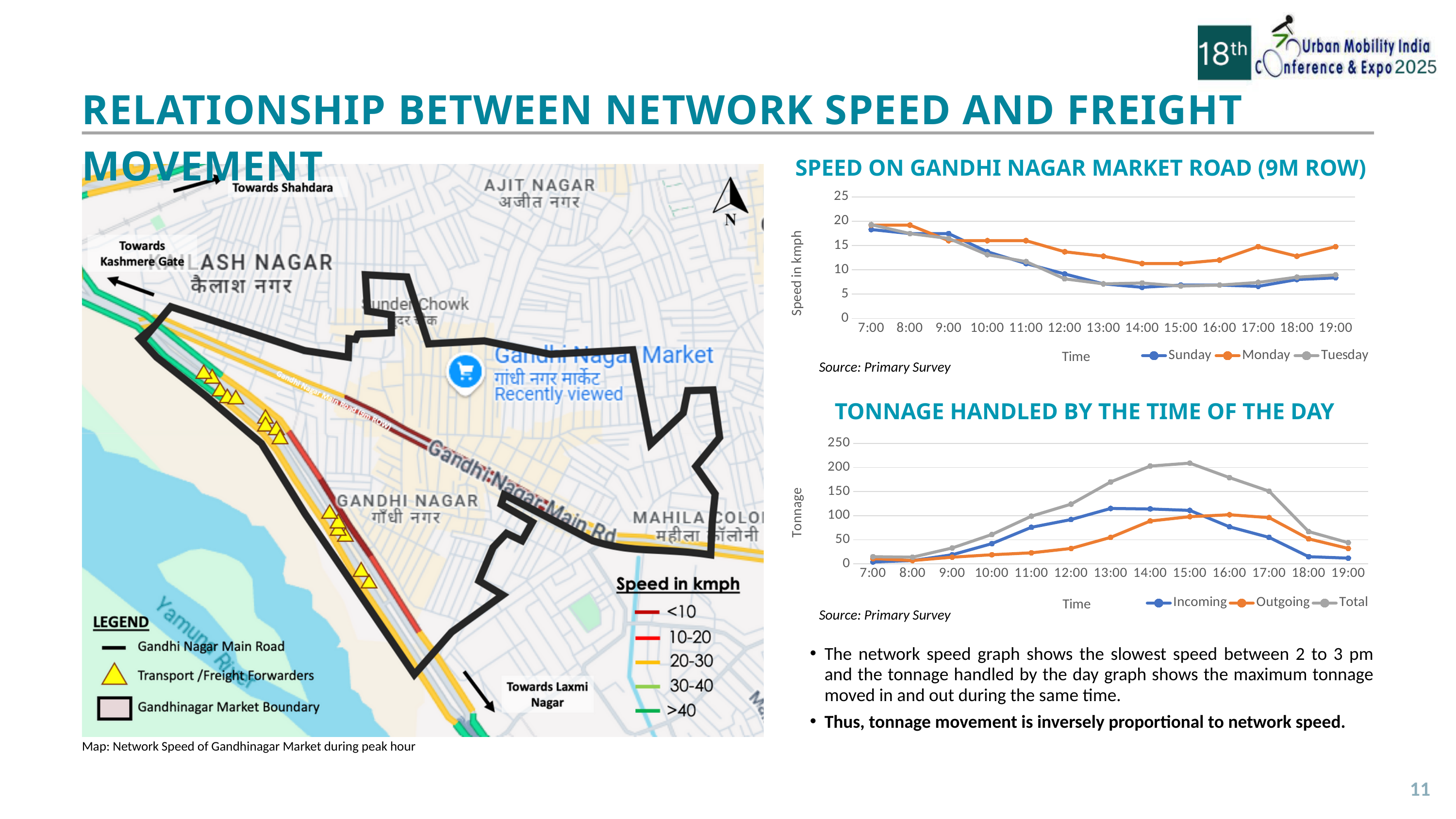
In the 'TONNAGE HANDLED BY THE TIME OF THE DAY' chart, is the Incoming value at 19:00 greater or less than 50? less What are the legend entries of the 'TONNAGE HANDLED BY THE TIME OF THE DAY' chart? Incoming, Outgoing, Total In the 'TONNAGE HANDLED BY THE TIME OF THE DAY' chart, which is larger at 13:00, Incoming or Outgoing? Incoming In the 'SPEED ON GANDHI NAGAR MARKET ROAD (9M ROW)' chart, is the Sunday value at 14:00 greater or less than 10? less How many time points are plotted along the x axis of the 'SPEED ON GANDHI NAGAR MARKET ROAD (9M ROW)' chart? 13 How many series does the legend of the 'SPEED ON GANDHI NAGAR MARKET ROAD (9M ROW)' chart list? 3 In the 'SPEED ON GANDHI NAGAR MARKET ROAD (9M ROW)' chart, does the Sunday line rise or fall from 7:00 to 14:00? Fall In the 'SPEED ON GANDHI NAGAR MARKET ROAD (9M ROW)' chart, which is higher at 17:00, Monday or Sunday? Monday In the 'TONNAGE HANDLED BY THE TIME OF THE DAY' chart, is the Total value at 15:00 greater or less than 150? greater How many series does the legend of the 'TONNAGE HANDLED BY THE TIME OF THE DAY' chart list? 3 What kind of chart is the 'SPEED ON GANDHI NAGAR MARKET ROAD (9M ROW)' chart? Line chart